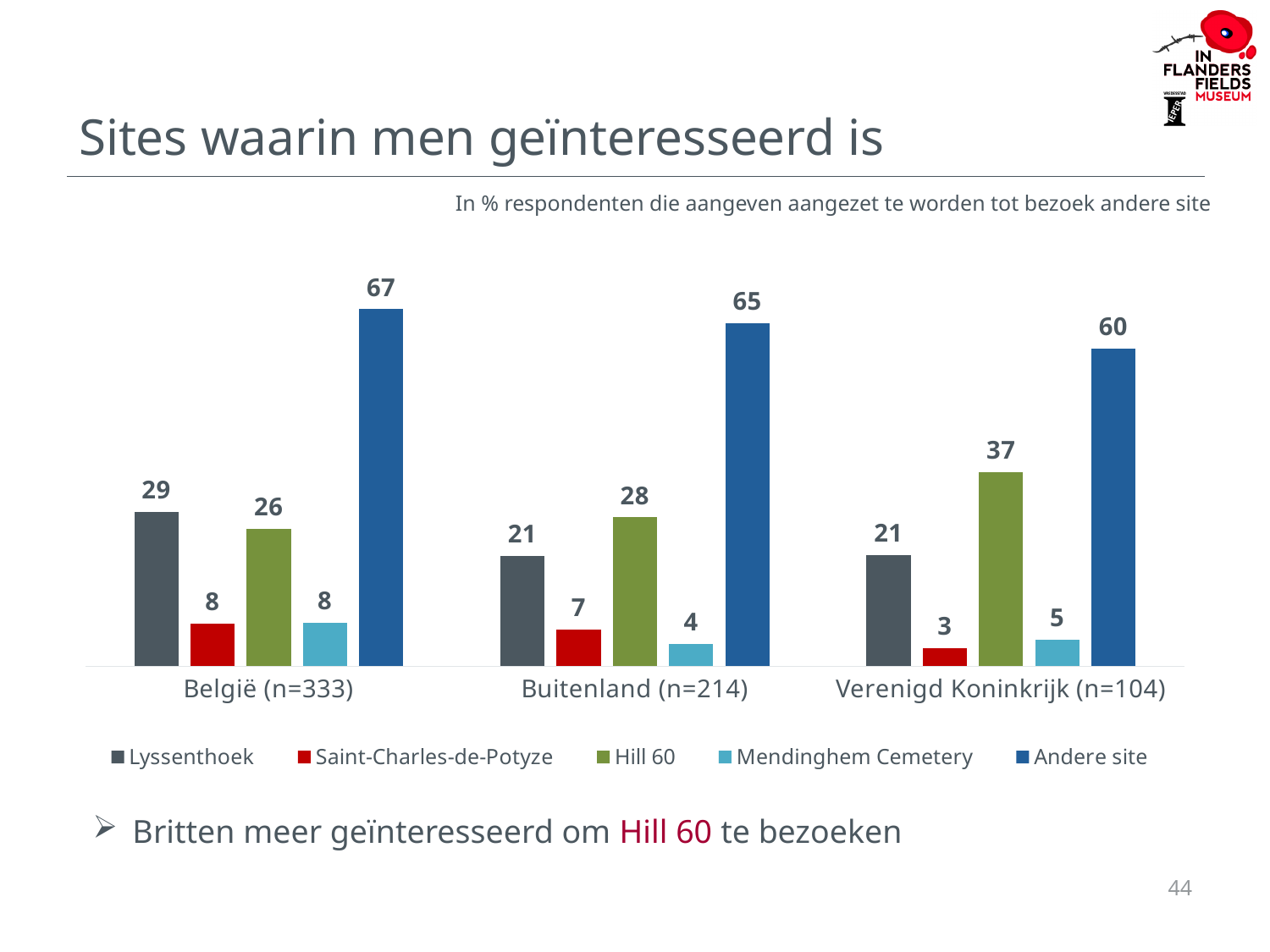
How many groups are shown on the x axis? 3 Which series is shown in red in the legend? Saint-Charles-de-Potyze How many series does the legend list? 5 What is the value for Saint-Charles-de-Potyze in the Buitenland (n=214) group? 7 Which is larger: Lyssenthoek in België (n=333) or Lyssenthoek in Buitenland (n=214)? België (n=333) Which series has the highest value in the Buitenland (n=214) group? Andere site Which series has the lowest value in the Verenigd Koninkrijk (n=104) group? Saint-Charles-de-Potyze What is the difference between the Hill 60 values for Verenigd Koninkrijk (n=104) and België (n=333)? 11 What kind of chart is shown on the slide? Bar chart What is the value for Hill 60 in the Verenigd Koninkrijk (n=104) group? 37 Do the Andere site values rise or fall from België to Verenigd Koninkrijk? Fall What is the value for Andere site in the België (n=333) group? 67